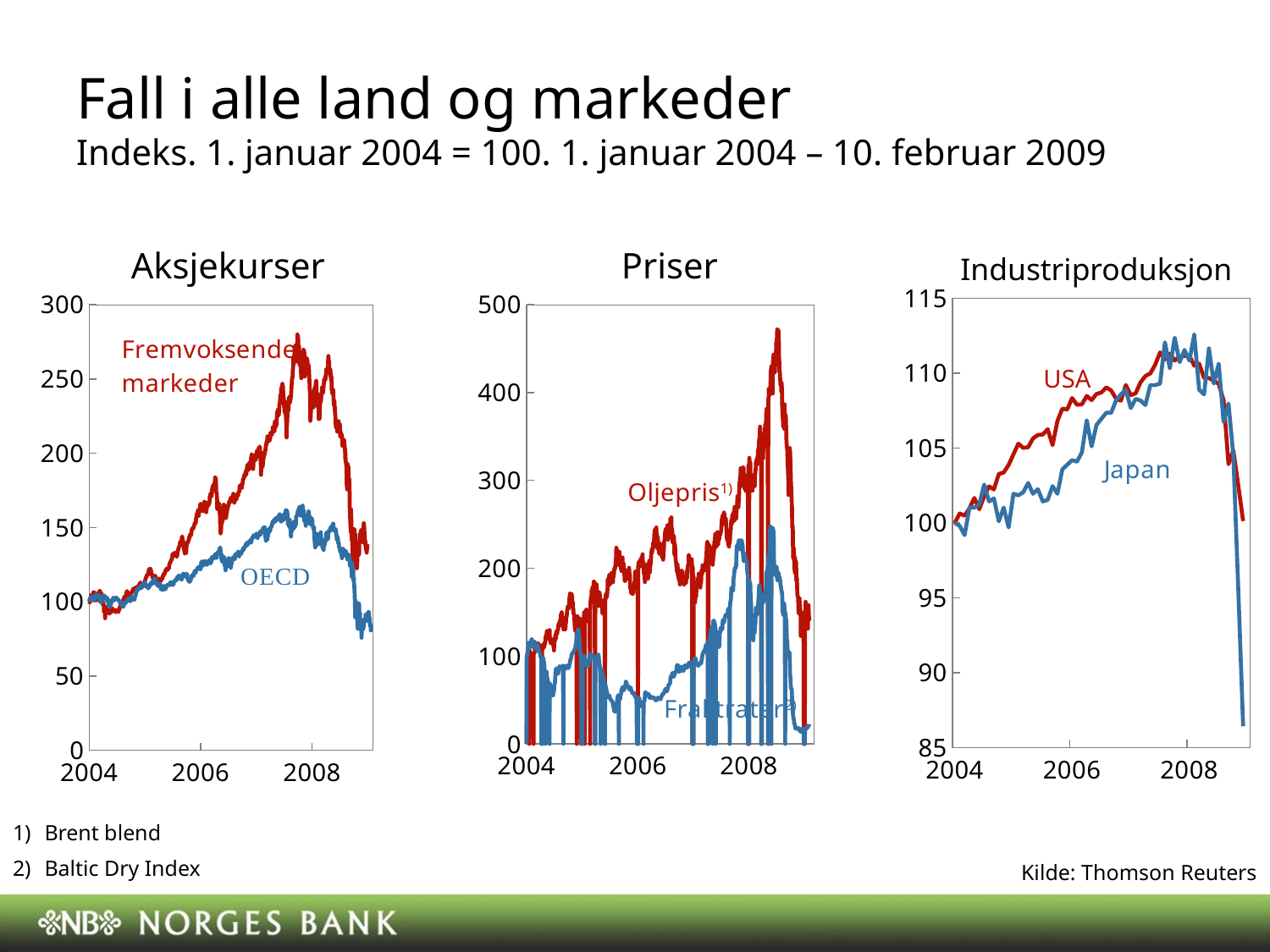
In the 'Aksjekurser' chart, which series reaches the higher peak, Fremvoksende markeder or OECD? Fremvoksende markeder How many charts are shown on the slide? 3 In the 'Priser' chart, is the peak value for Fraktrater greater or less than 300? less According to the footnote, what does 'Oljepris' refer to? Brent blend In the 'Priser' chart, is the peak value for Oljepris greater or less than 400? greater In the 'Aksjekurser' chart, is the peak value for OECD greater or less than 200? less What is the index value of all series at 1 January 2004, according to the slide? 100 What kind of chart is the 'Aksjekurser' chart? Line chart In the 'Industriproduksjon' chart, what is the overall trend of the series from 2004 to 2008 before the final drop? Rising In the 'Aksjekurser' chart, how many series are plotted? 2